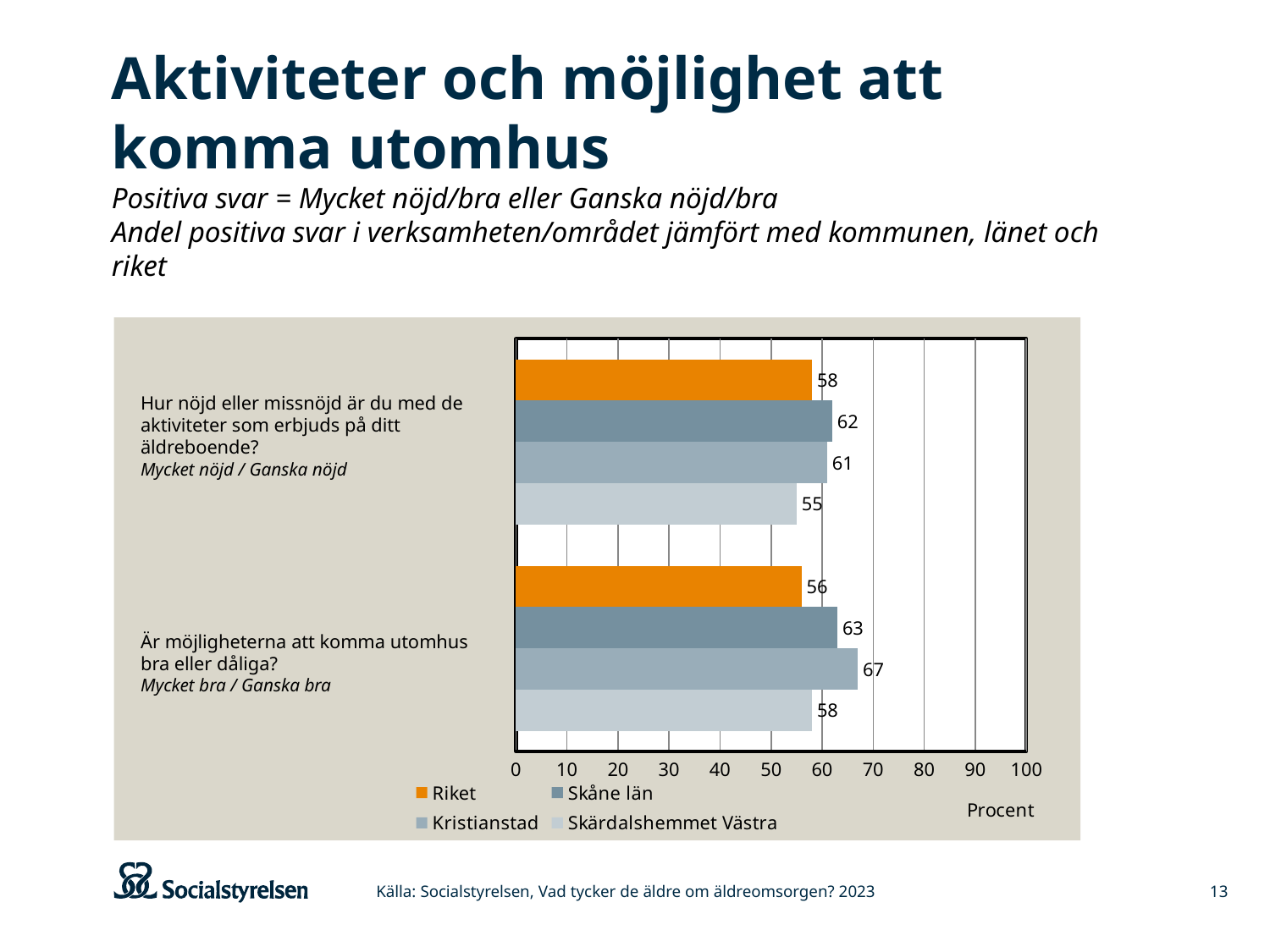
What is the value for Skärdalshemmet Västra on the question "Är möjligheterna att komma utomhus bra eller dåliga?"? 58 What kind of chart is shown on the slide? Bar chart Which series has the highest value on the question "Är möjligheterna att komma utomhus bra eller dåliga?"? Kristianstad Which is larger on the question "Är möjligheterna att komma utomhus bra eller dåliga?": Riket or Skåne län? Skåne län Which series has the lowest value on the question about satisfaction with activities offered at the care home? Skärdalshemmet Västra How many question categories are shown on the chart? 2 What is the value for Riket on the question about satisfaction with activities offered at the care home ("Hur nöjd eller missnöjd är du med de aktiviteter som erbjuds på ditt äldreboende?")? 58 What unit is shown on the horizontal axis of the chart? Procent How many series does the legend list? 4 What is the value for Kristianstad on the question "Är möjligheterna att komma utomhus bra eller dåliga?"? 67 What is the difference between Skåne län and Skärdalshemmet Västra on the question about satisfaction with activities offered at the care home? 7 Is the value for Kristianstad on the question about satisfaction with activities offered at the care home greater or less than 50? greater